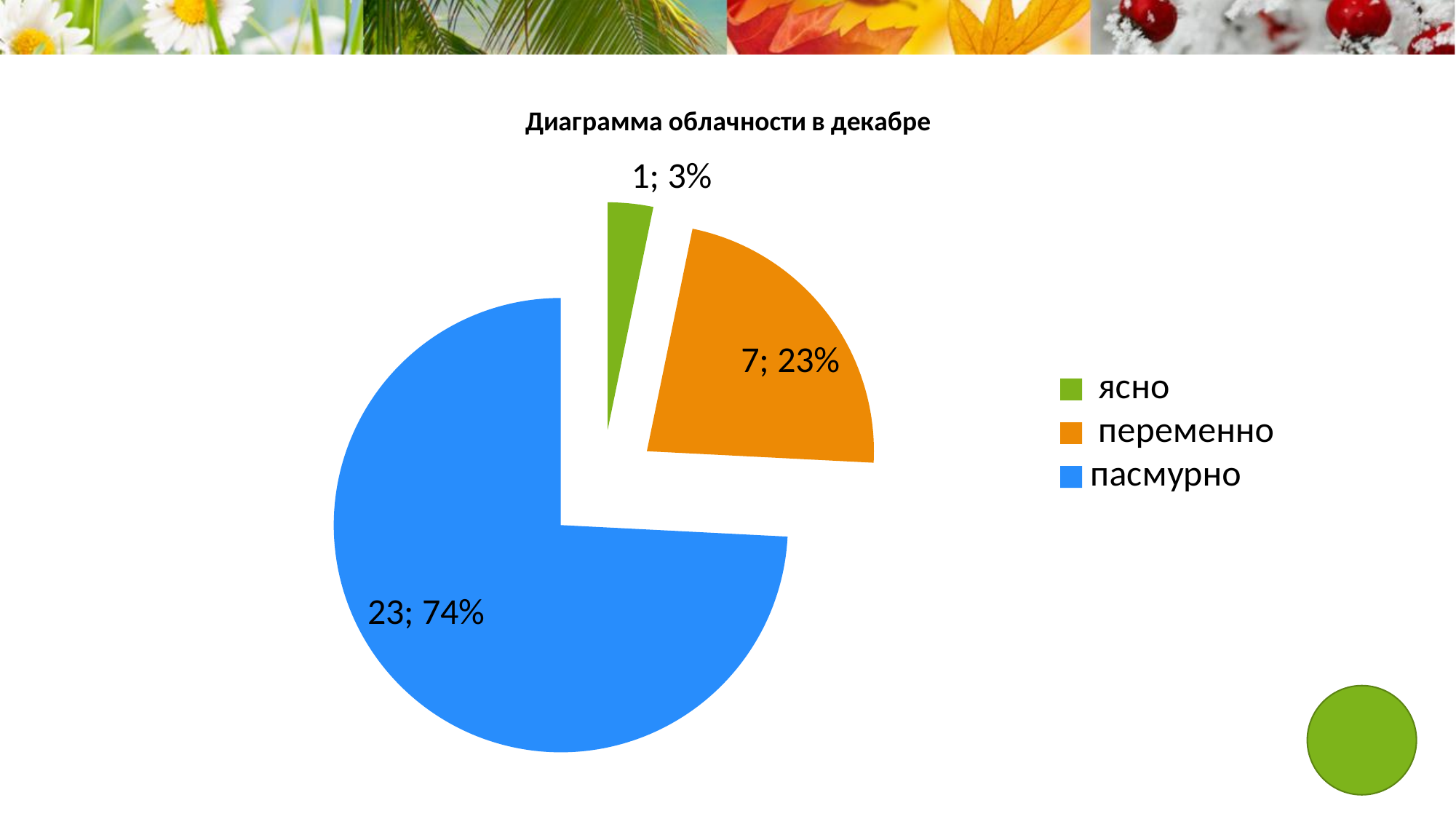
What type of chart is shown on the slide? pie chart What is the difference between the values for пасмурно and переменно? 16 Which category has the largest slice? пасмурно What share of the pie does пасмурно represent? 74% How many slices does the pie chart have? 3 Which category has the smallest slice? ясно What is the title of the chart? Диаграмма облачности в декабре How many entries does the legend list? 3 What is the value for пасмурно? 23 What is the value for ясно? 1 What is the value for переменно? 7 What share of the pie does переменно represent? 23%